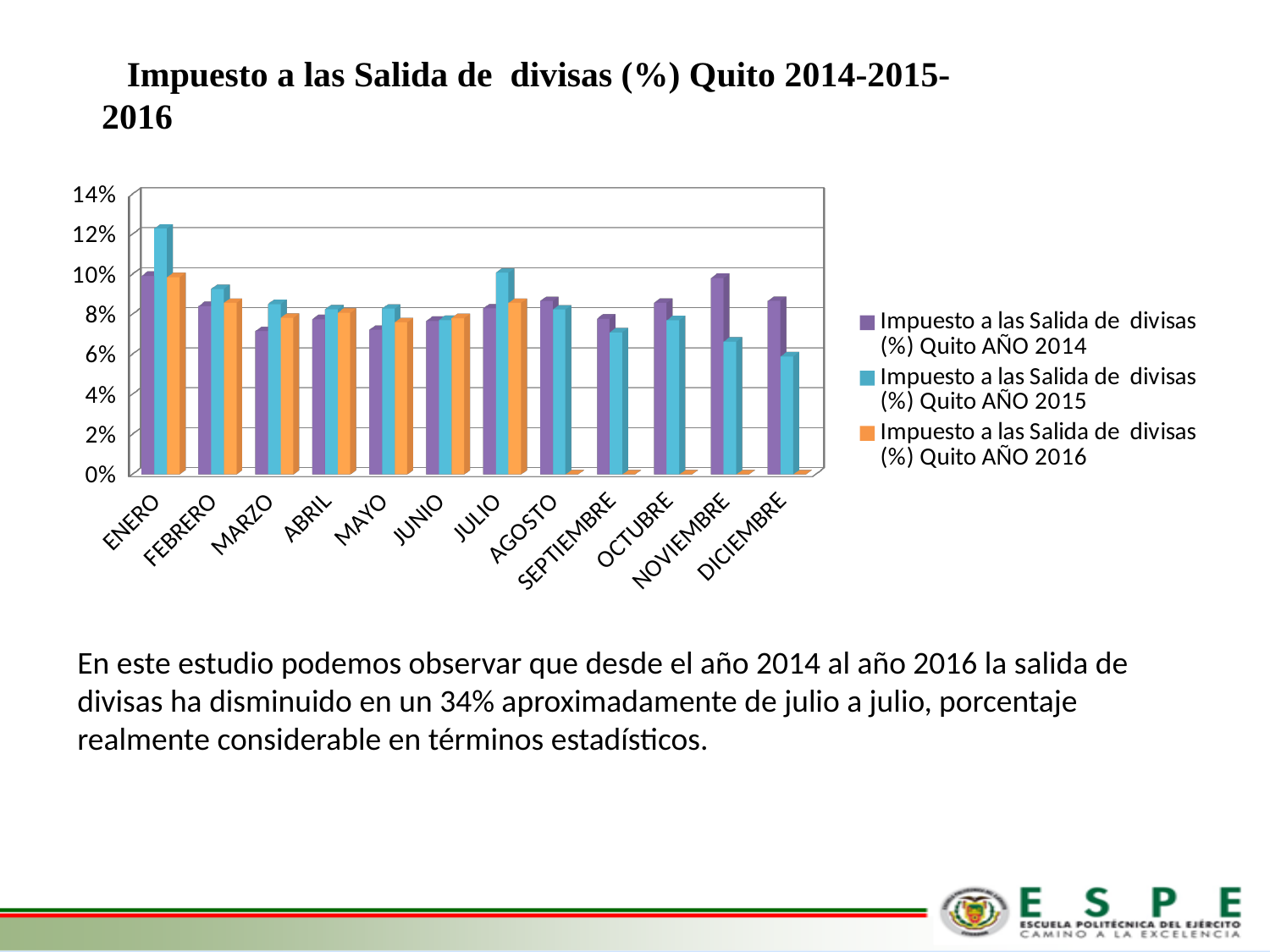
How many months (categories) are shown on the x axis of the chart? 12 What kind of chart is shown on the slide? Bar chart In which month is the value for the AÑO 2015 series lowest? DICIEMBRE What colour represents the AÑO 2016 series in the chart? Orange Is the value for NOVIEMBRE in the AÑO 2015 series greater or less than 8%? less In which month is the value for the AÑO 2015 series highest? ENERO Is the value for MARZO in the AÑO 2014 series greater or less than 8%? less For ENERO, which series has the larger value: AÑO 2014 or AÑO 2015? AÑO 2015 How many series does the chart's legend list? 3 Is the value for ENERO in the AÑO 2015 series greater or less than 10%? greater Do the values for the AÑO 2015 series rise or fall from JULIO to DICIEMBRE? fall For NOVIEMBRE, which series has the larger value: AÑO 2014 or AÑO 2015? AÑO 2014